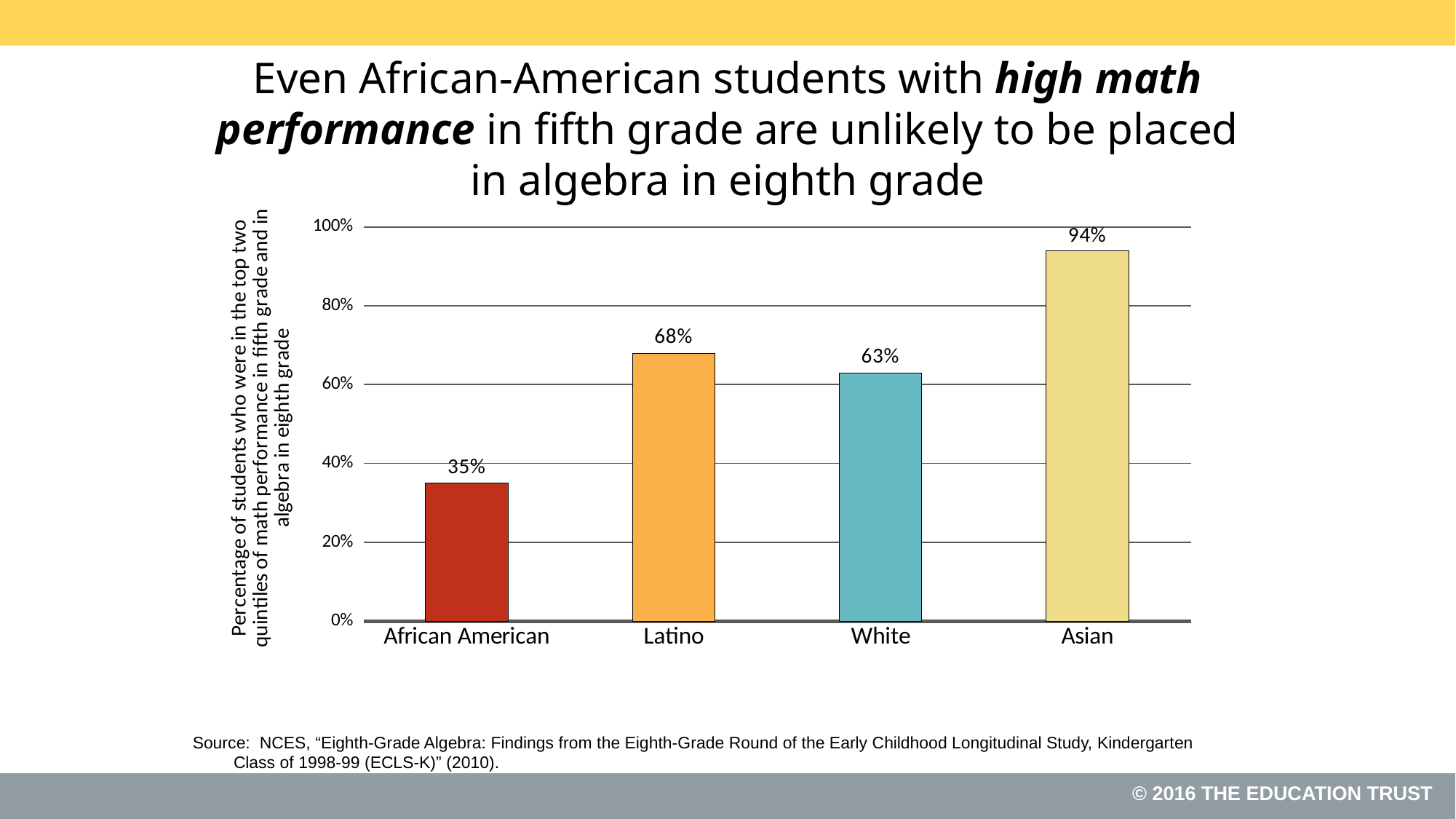
What is the difference between the values for Latino and White students? 5% How many categories are shown on the x axis? 4 Which category has the lowest value? African American What is the value for White students? 63% Which category has the highest value? Asian Which is larger, the value for Latino or the value for White? Latino What is the value for African American students? 35% Is the value for African American students greater or less than 40%? less What is the value for Asian students? 94% What kind of chart is shown on the slide? bar chart What is the value for Latino students? 68% What is the difference between the values for Asian and African American students? 59%